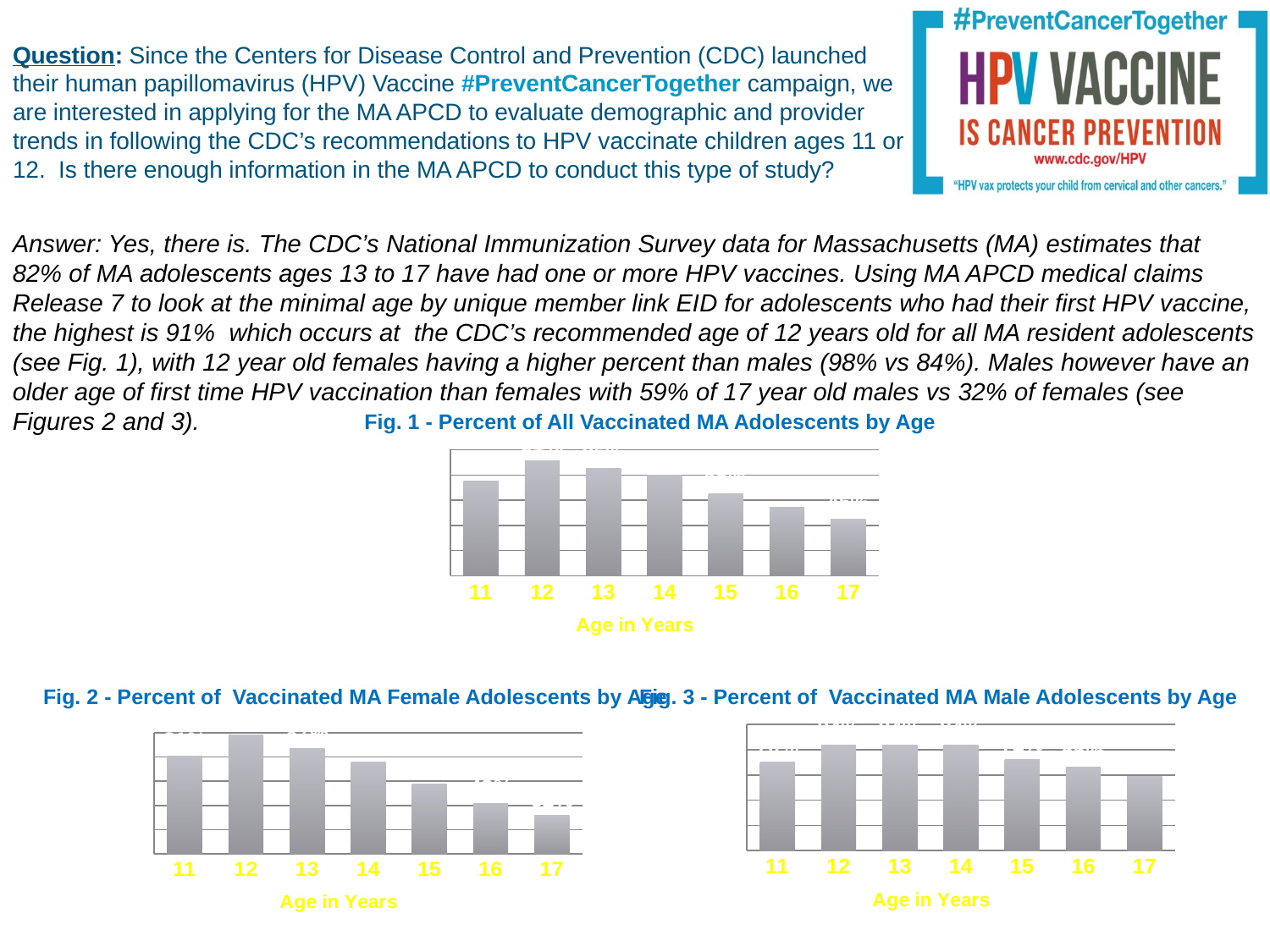
In Fig. 1 - Percent of All Vaccinated MA Adolescents by Age, do the bars rise or fall from age 12 to age 17? Fall In Fig. 1 - Percent of All Vaccinated MA Adolescents by Age, which bar is taller, age 11 or age 17? Age 11 What is the x-axis title of the chart in Fig. 3 - Percent of Vaccinated MA Male Adolescents by Age? Age in Years In Fig. 3 - Percent of Vaccinated MA Male Adolescents by Age, which age has the lowest bar? 17 What kind of chart is Fig. 1 - Percent of All Vaccinated MA Adolescents by Age? Bar chart In Fig. 1 - Percent of All Vaccinated MA Adolescents by Age, which age has the highest bar? 12 In Fig. 1 - Percent of All Vaccinated MA Adolescents by Age, which age has the lowest bar? 17 In Fig. 2 - Percent of Vaccinated MA Female Adolescents by Age, which bar is taller, age 13 or age 15? Age 13 In Fig. 2 - Percent of Vaccinated MA Female Adolescents by Age, which age has the lowest bar? 17 How many age categories are shown on the x axis of Fig. 1 - Percent of All Vaccinated MA Adolescents by Age? 7 In Fig. 2 - Percent of Vaccinated MA Female Adolescents by Age, which age has the highest bar? 12 In Fig. 3 - Percent of Vaccinated MA Male Adolescents by Age, which bar is taller, age 14 or age 17? Age 14